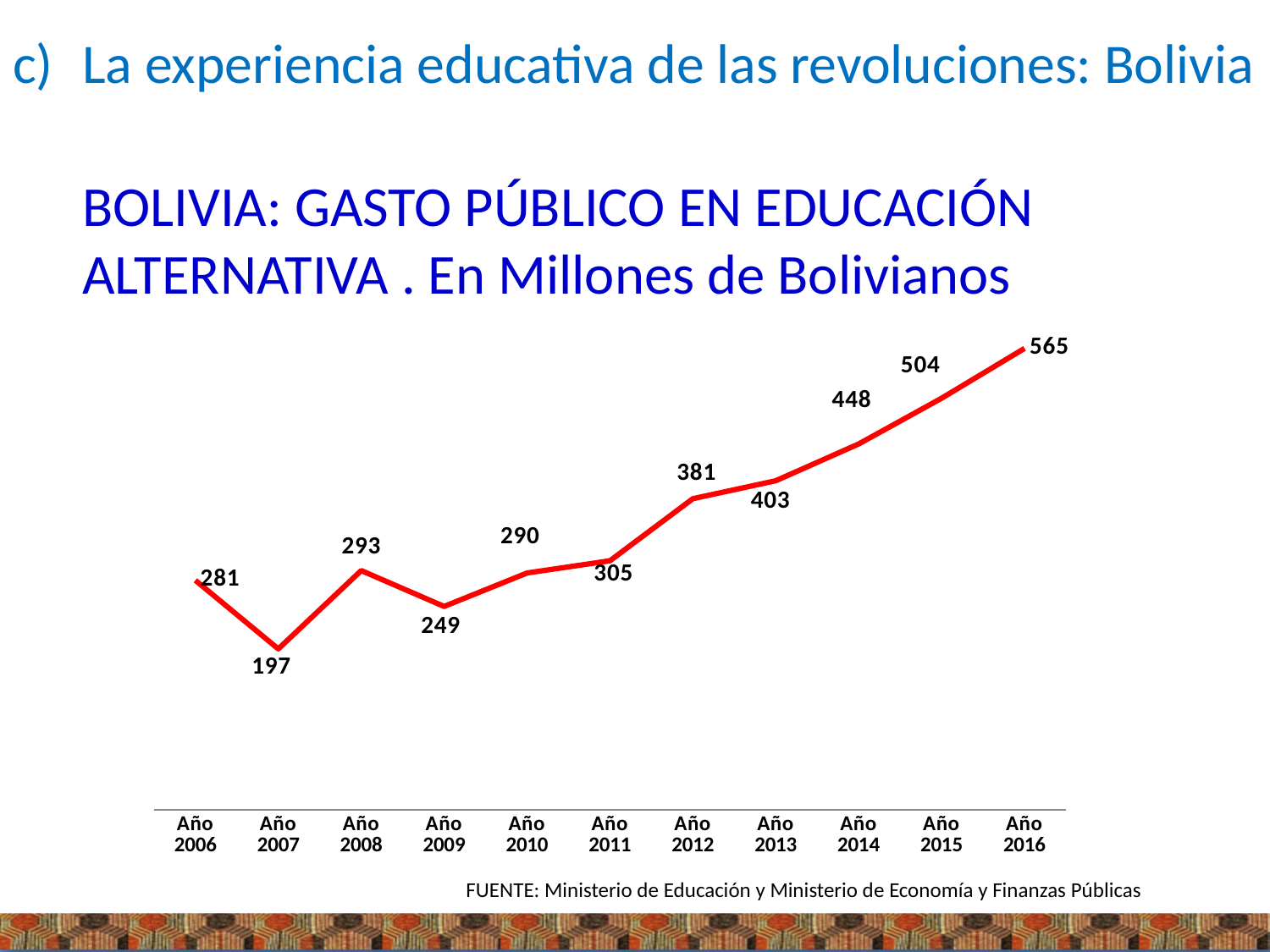
What unit is the public spending expressed in, according to the chart title? Millones de Bolivianos What is the value for Año 2012? 381 What is the difference between the values for Año 2008 and Año 2009? 44 Do the values generally rise or fall from Año 2009 to Año 2016? rise Which is larger, the value for Año 2010 or the value for Año 2011? Año 2011 Which year has the lowest value? Año 2007 Which year has the highest value? Año 2016 What type of chart is shown on the slide? line chart How many years are plotted on the chart? 11 What is the value for Año 2016? 565 What is the difference between the values for Año 2016 and Año 2015? 61 What is the value for Año 2006? 281